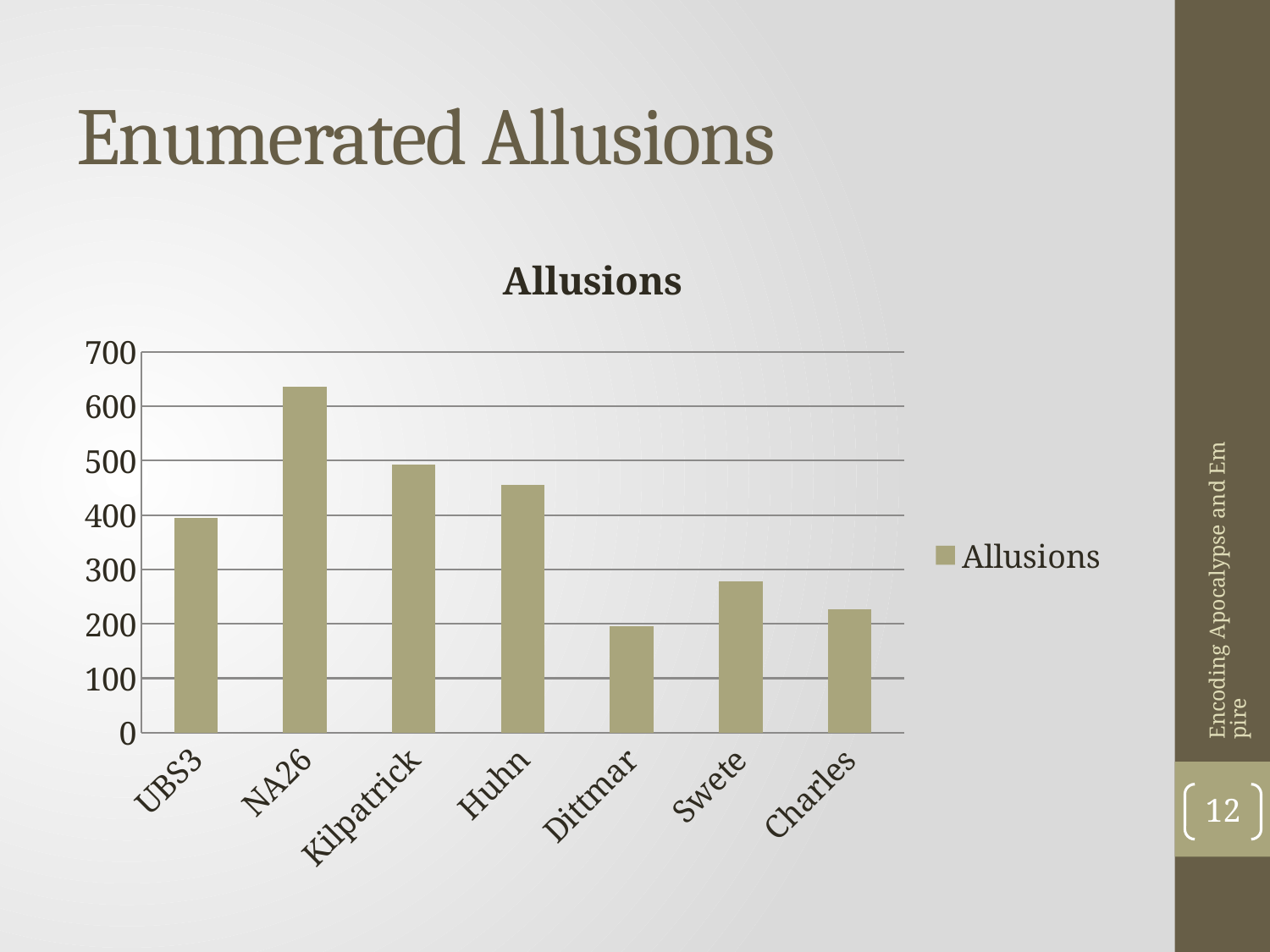
Is the value for Dittmar greater or less than 300? less What is the title of the chart? Allusions Is the value for Swete greater or less than 300? less Is the value for UBS3 greater or less than 300? greater Which has more allusions, Kilpatrick or Huhn? Kilpatrick Which category has the highest number of allusions? NA26 How many series does the legend list? 1 What type of chart is shown on the slide? bar chart Which category has the lowest number of allusions? Dittmar Which has more allusions, Swete or Charles? Swete How many categories are shown on the x axis? 7